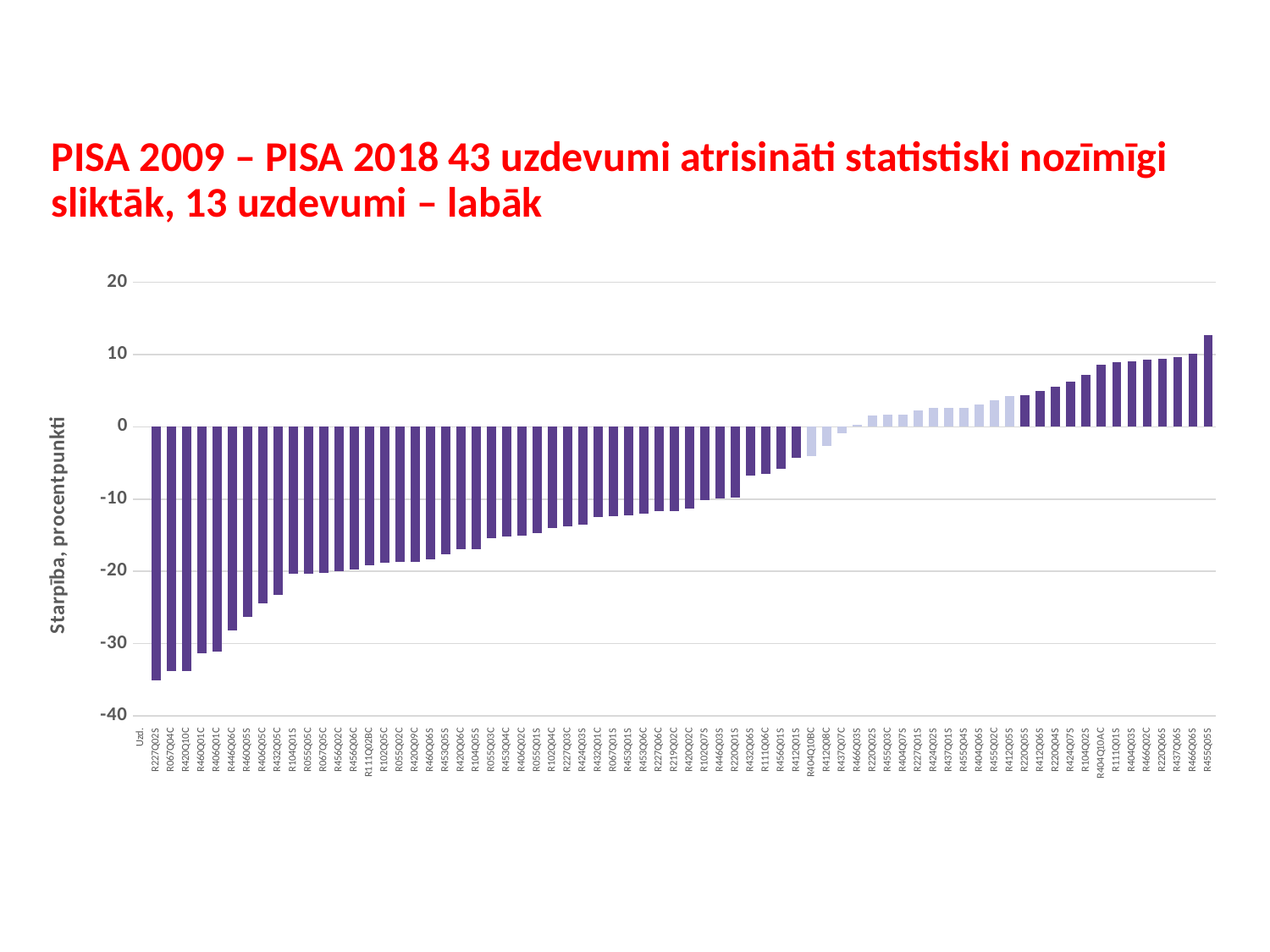
Do the bar values rise or fall from left to right along the x axis? rise What is the highest value shown on the vertical axis? 20 Which category has the lowest value in the chart? R227Q02S Which category has the highest value in the chart? R455Q05S Is the value for R067Q04C greater or less than -30? less Is the value for R455Q05S greater or less than 10? greater Which has the larger value, R227Q02S or R455Q05S? R455Q05S What kind of chart is shown on the slide? bar chart Is the value for R227Q02S greater or less than -30? less What is the label of the vertical axis? Starpība, procentpunkti